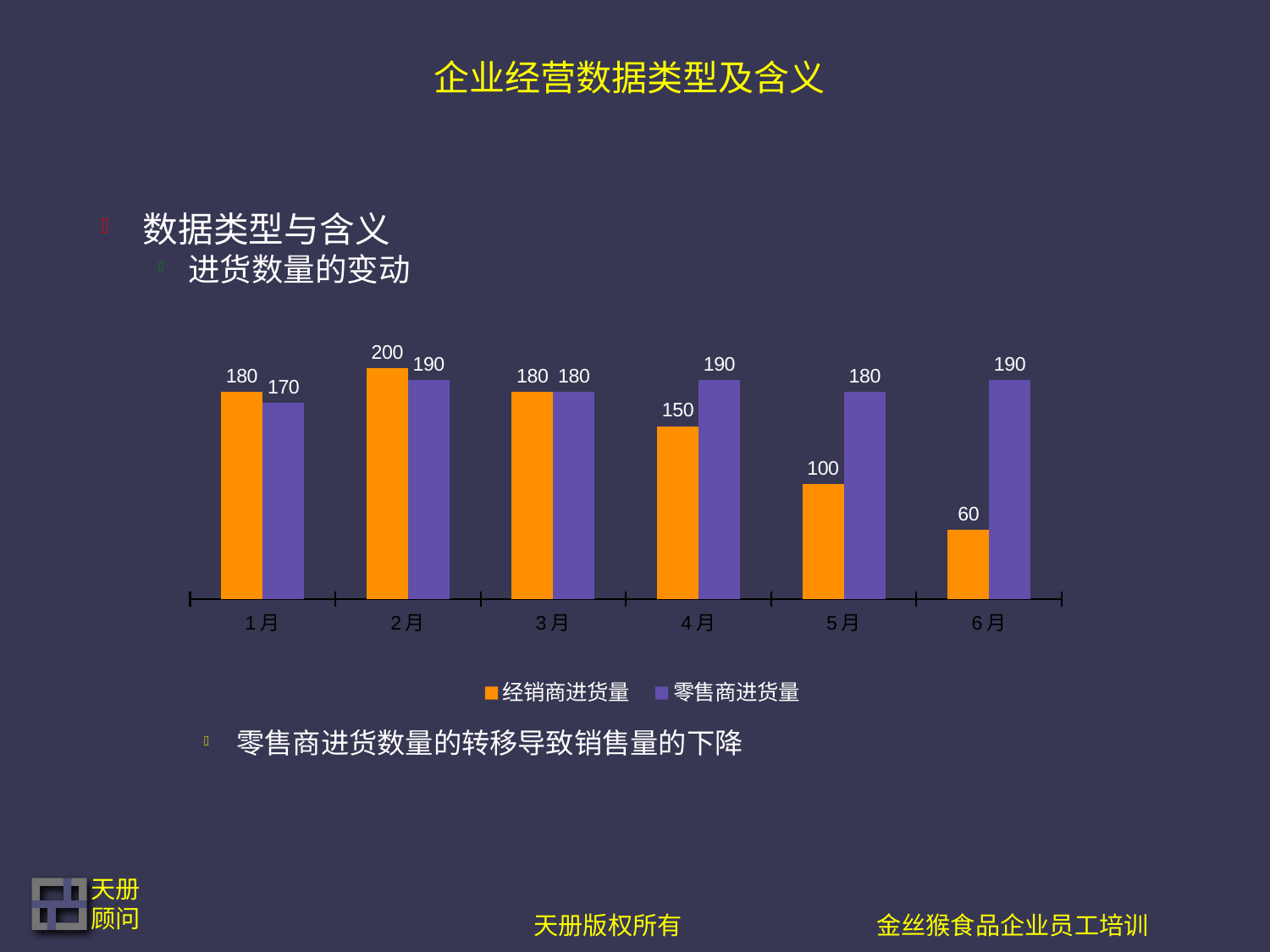
What is the value of 零售商进货量 for 6月? 190 What kind of chart is shown on the slide? bar chart Which colour represents 零售商进货量 in the legend? purple In 4月, which is larger: 经销商进货量 or 零售商进货量? 零售商进货量 How many months are shown on the x axis? 6 Which month has the lowest value for 经销商进货量? 6月 What is the value of 经销商进货量 for 5月? 100 From 2月 to 6月, does 经销商进货量 rise or fall? fall How many series does the legend list? 2 What is the difference between 零售商进货量 and 经销商进货量 in 6月? 130 Which month has the highest value for 经销商进货量? 2月 What is the value of 经销商进货量 for 2月? 200